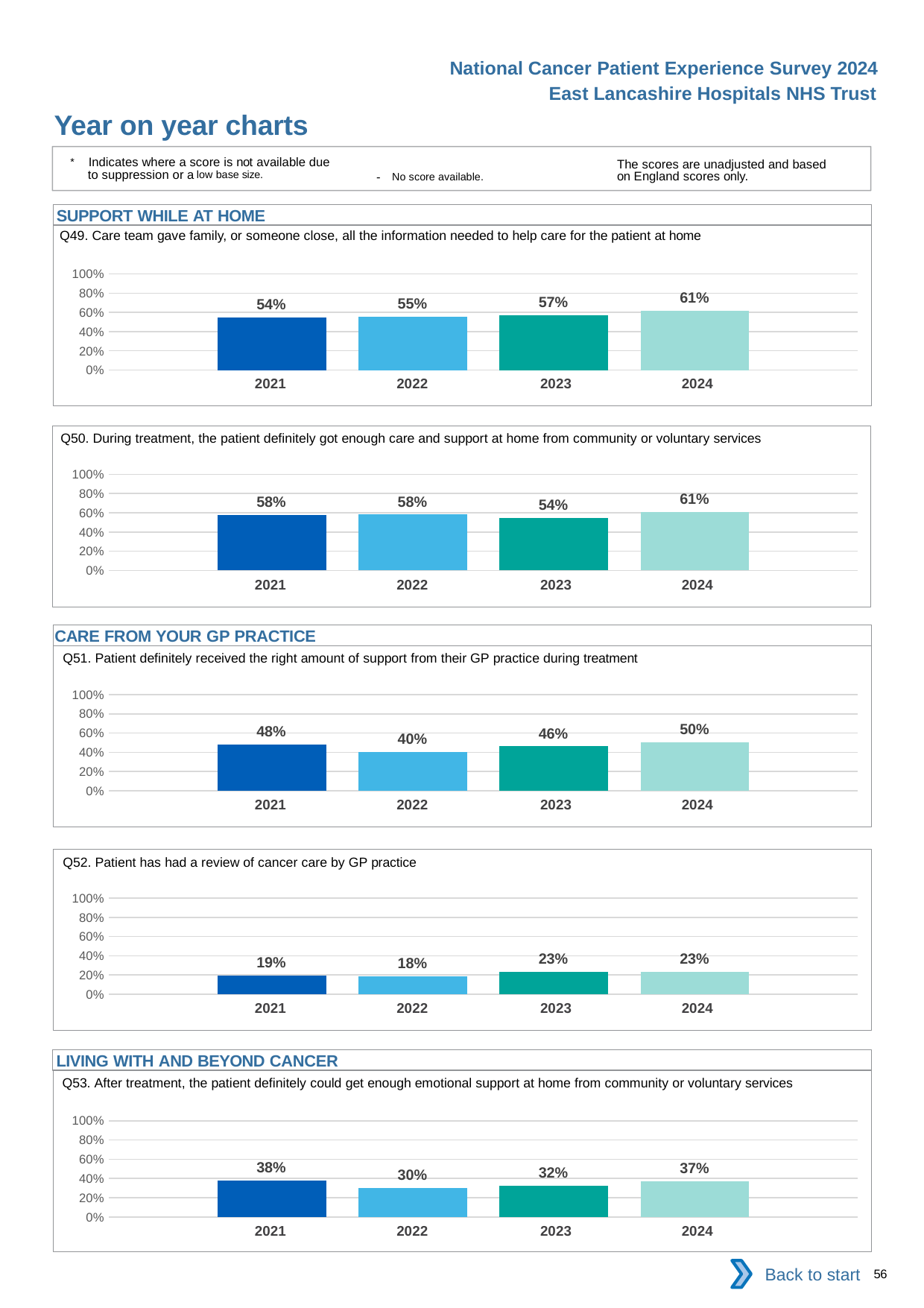
In the Q52 chart (review of cancer care by GP practice), what is the value for 2022? 18% How many years are plotted in the Q49 chart? 4 What kind of chart is the Q52 chart? Bar chart In the Q50 chart, what is the difference between the 2024 value and the 2023 value? 7 percentage points In the Q51 chart (right amount of support from GP practice during treatment), which year has the lowest value? 2022 In the Q51 chart, what is the value for 2021? 48% In the Q52 chart, is the value for 2021 greater or less than 20%? less In the Q50 chart (enough care and support at home from community or voluntary services), what is the value for 2023? 54% In the Q53 chart (emotional support at home after treatment), which year has the highest value? 2021 In the Q49 chart (care team gave family all the information needed to help care for the patient at home), what is the value for 2024? 61% In the Q53 chart, which is larger, the value for 2022 or the value for 2023? 2023 In the Q49 chart, which year has the lowest value? 2021